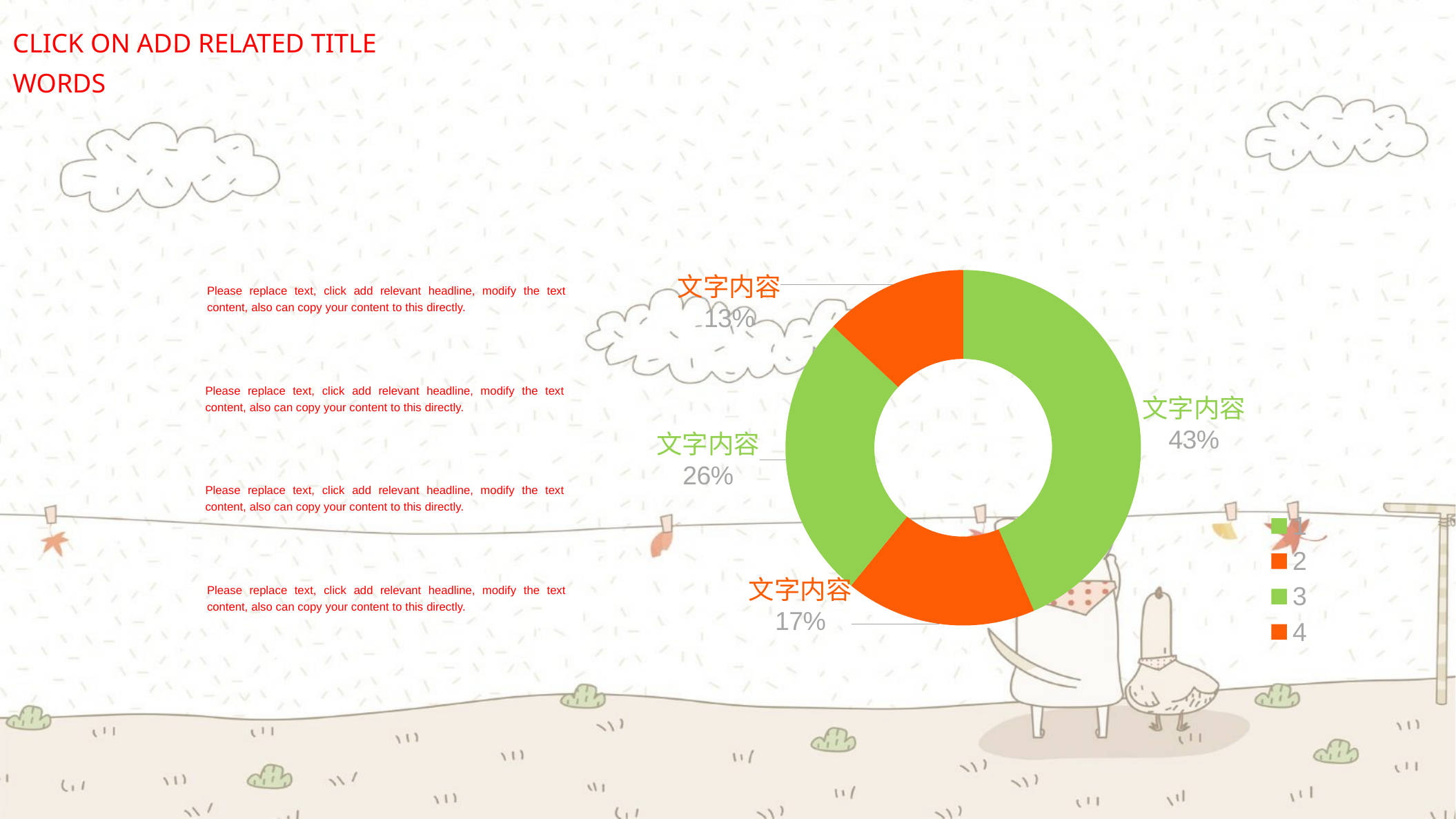
What kind of chart is shown on the slide? Doughnut chart How many slices does the doughnut chart have? 4 Which slice is larger, the one labelled 26% or the one labelled 17%? 26% What colour is the slice labelled 43% in the doughnut chart? Green What percentage is shown for the largest slice of the doughnut chart? 43% What is the difference in percentage points between the largest slice (43%) and the smallest slice (13%)? 30 How many entries does the chart's legend list? 4 What percentage is shown for the smallest slice of the doughnut chart? 13%